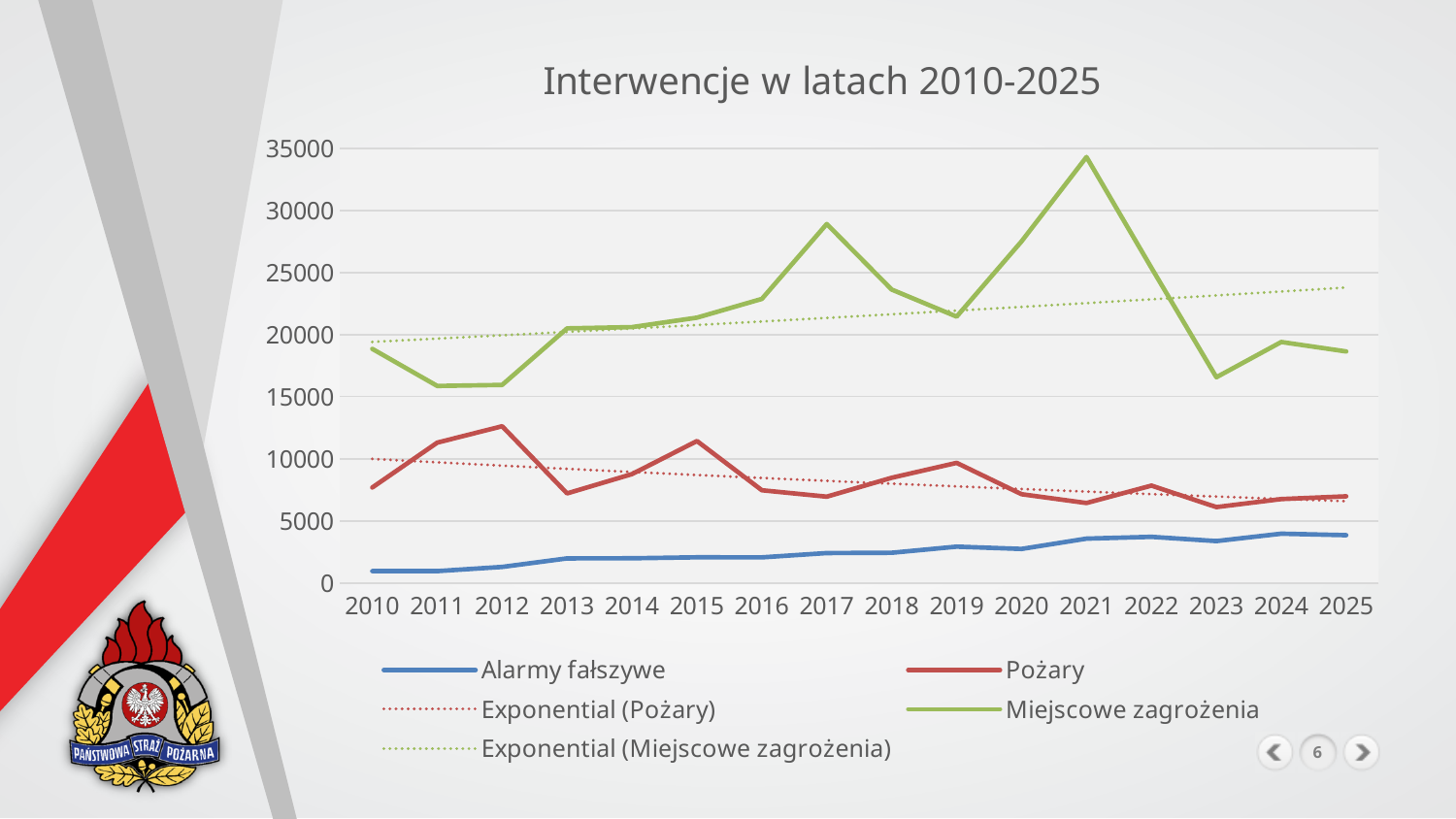
Is the value for Pożary in 2012 greater or less than 10000? greater How many entries does the chart legend list? 5 What kind of chart is shown on the slide? line chart Is the value for Alarmy fałszywe in 2010 greater or less than 5000? less In which year does the Miejscowe zagrożenia series reach its highest value? 2021 Which year has the larger value for Miejscowe zagrożenia, 2017 or 2021? 2021 In which year does the Pożary series reach its highest value? 2012 Is the value for Miejscowe zagrożenia in 2021 greater or less than 30000? greater Does the Alarmy fałszywe series generally rise or fall from 2010 to 2025? rise What is the title of the chart? Interwencje w latach 2010-2025 How many years are plotted along the x axis? 16